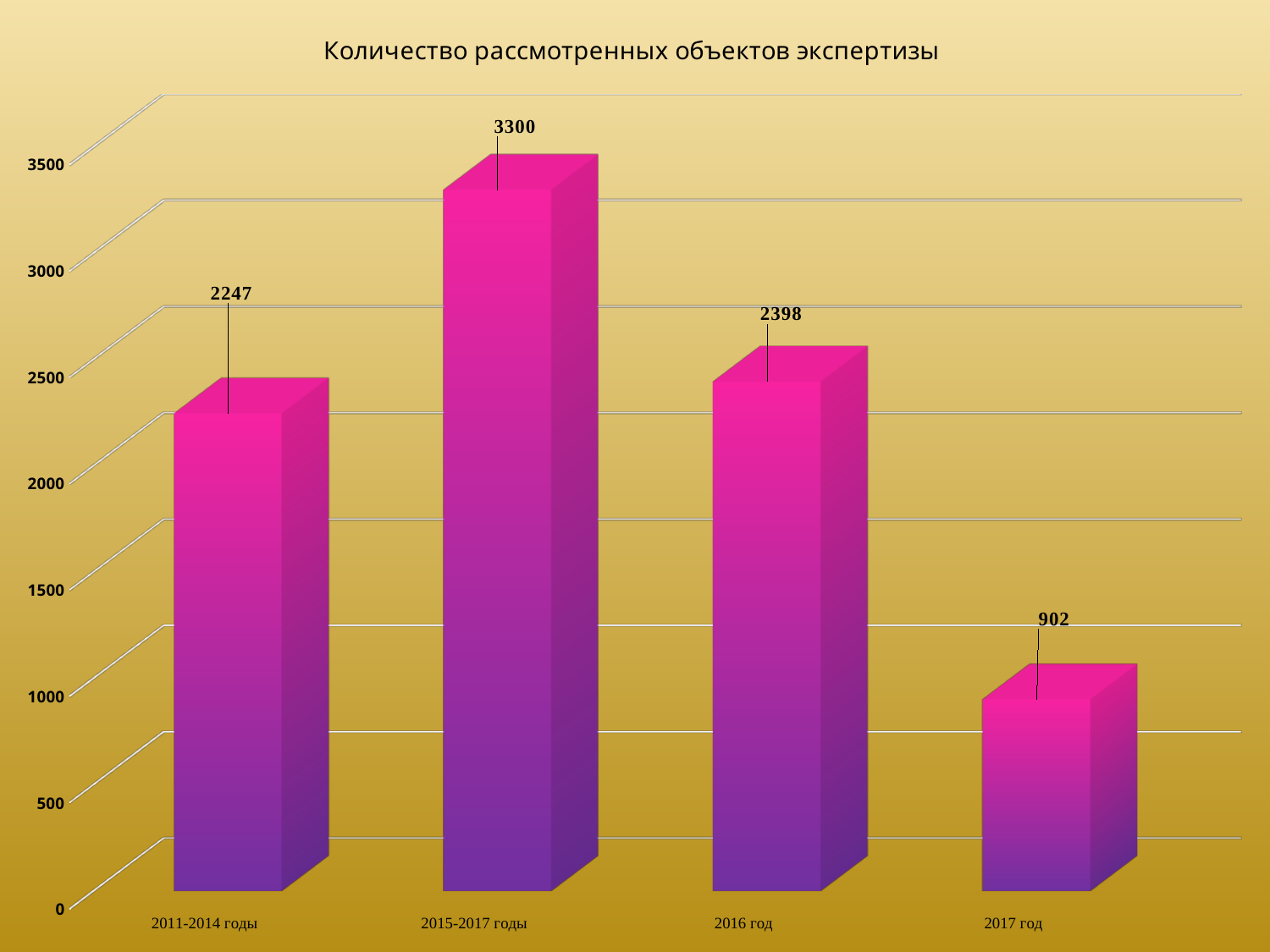
Which category has the lowest value? 2017 год What is the value for 2011-2014 годы? 2247 What is the value for 2017 год? 902 What is the difference between the values for 2015-2017 годы and 2016 год? 902 Which category has the highest value? 2015-2017 годы What is the difference between the values for 2016 год and 2011-2014 годы? 151 What kind of chart is shown on the slide? bar chart How many categories are shown on the x axis? 4 What is the title of the chart? Количество рассмотренных объектов экспертизы What is the value for 2015-2017 годы? 3300 What is the value for 2016 год? 2398 Which is larger, the value for 2011-2014 годы or the value for 2016 год? 2016 год